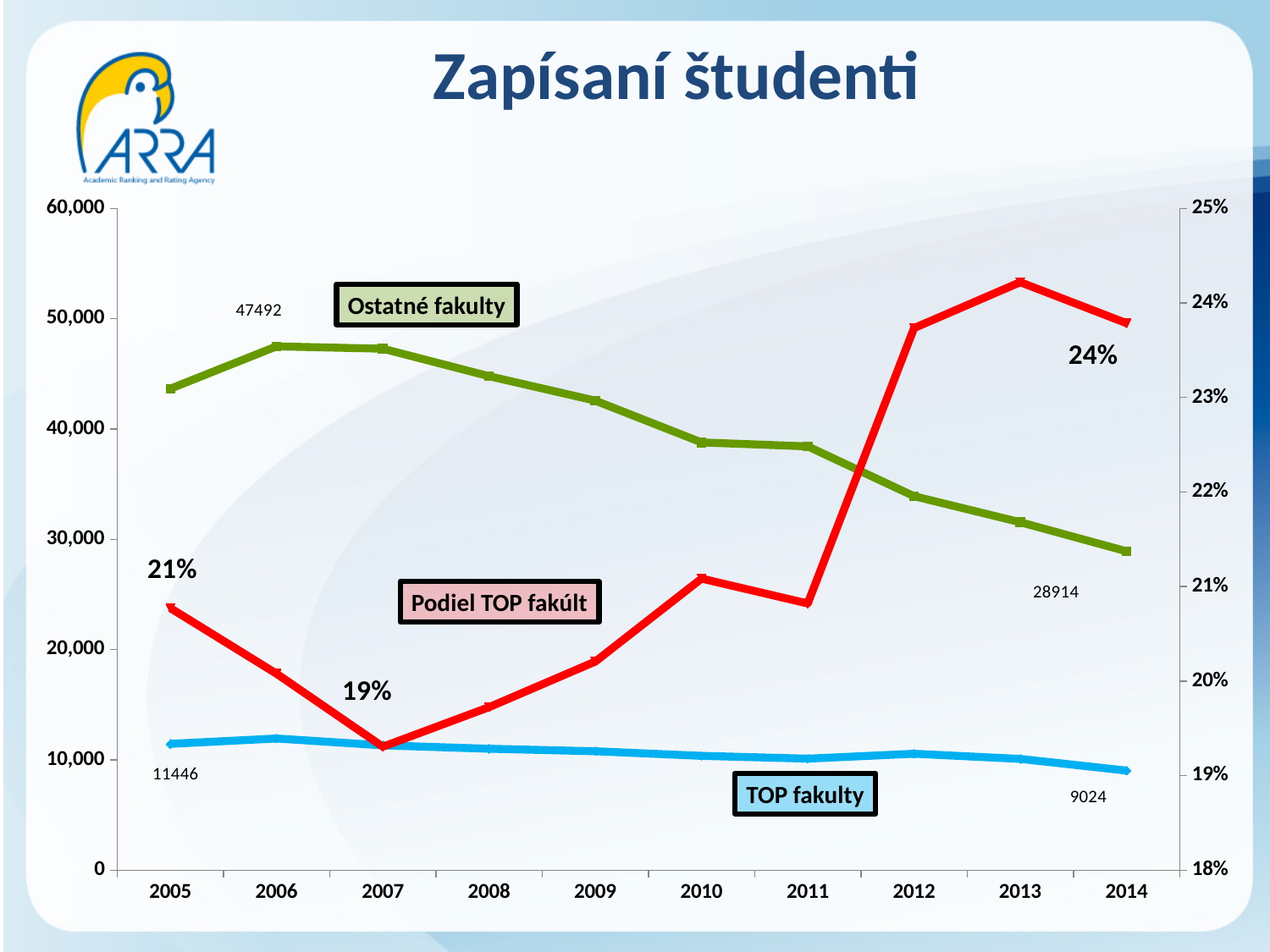
What is the value for Ostatné fakulty in 2014? 28914 What is the value for TOP fakulty in 2005? 11446 What is the Podiel TOP fakúlt value in 2007? 19% What is the value for Ostatné fakulty in 2006? 47492 Is the value for Ostatné fakulty in 2010 greater or less than 40,000? less In which year is the Podiel TOP fakúlt line at its highest? 2013 What is the difference between the TOP fakulty values in 2005 and 2014? 2422 What is the value for TOP fakulty in 2014? 9024 In which year is the Podiel TOP fakúlt line at its lowest? 2007 What kind of chart is shown on the slide? line chart By how much did the Ostatné fakulty value fall from 2006 to 2014? 18578 What is the Podiel TOP fakúlt value in 2014? 24%